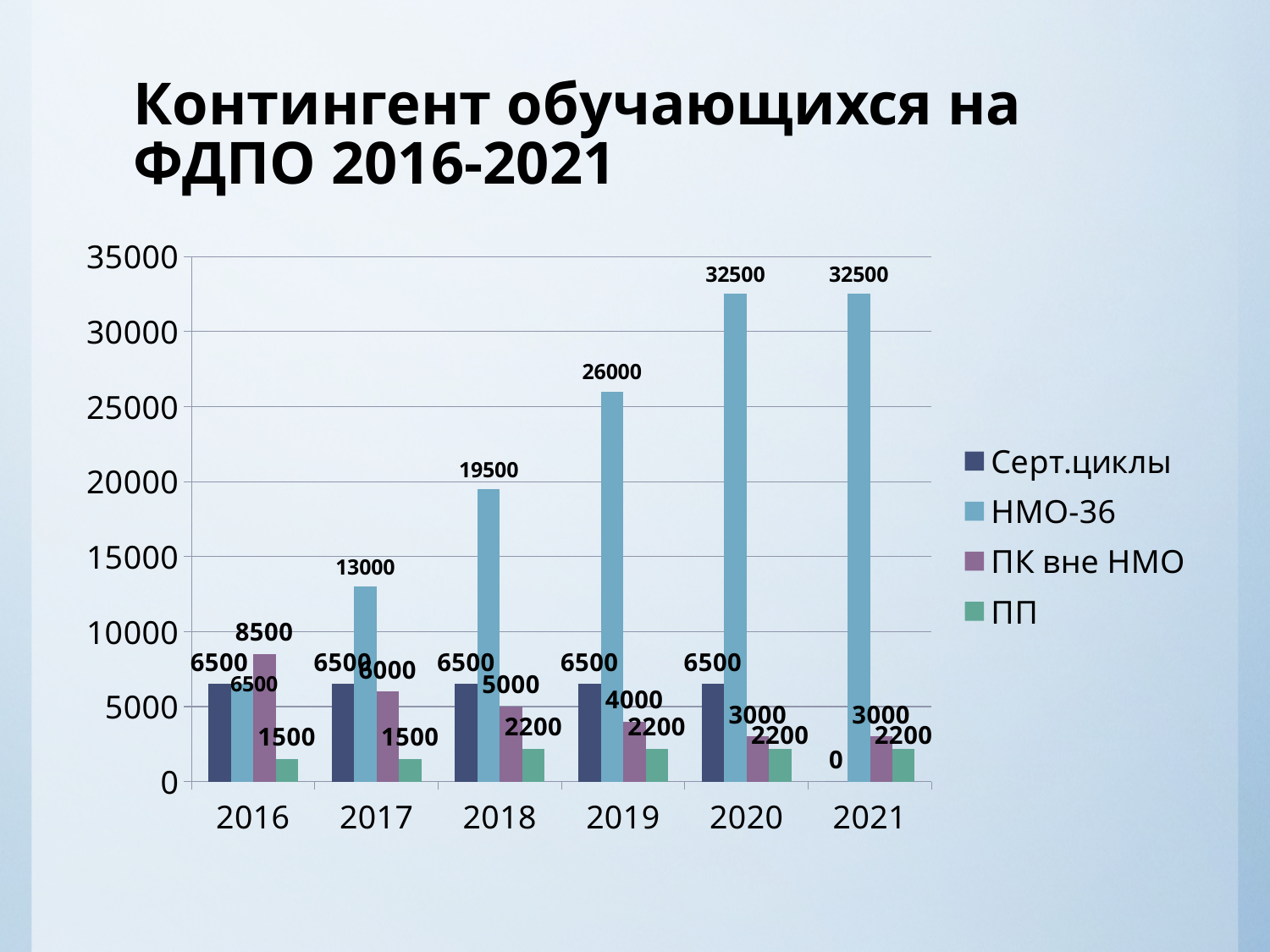
In which year is the value for НМО-36 the lowest? 2016 What is the value for ПП in 2017? 1500 What is the difference between the НМО-36 values for 2018 and 2017? 6500 What is the value for Серт.циклы in 2021? 0 Does the value for НМО-36 rise or fall from 2016 to 2020? rise What is the value for ПК вне НМО in 2016? 8500 How many years are shown on the x axis? 6 What is the value for НМО-36 in 2019? 26000 In which year is the value for ПК вне НМО the highest? 2016 What kind of chart is shown on the slide? bar chart Which is larger in 2017: the value for НМО-36 or the value for ПК вне НМО? НМО-36 How many series does the legend list? 4